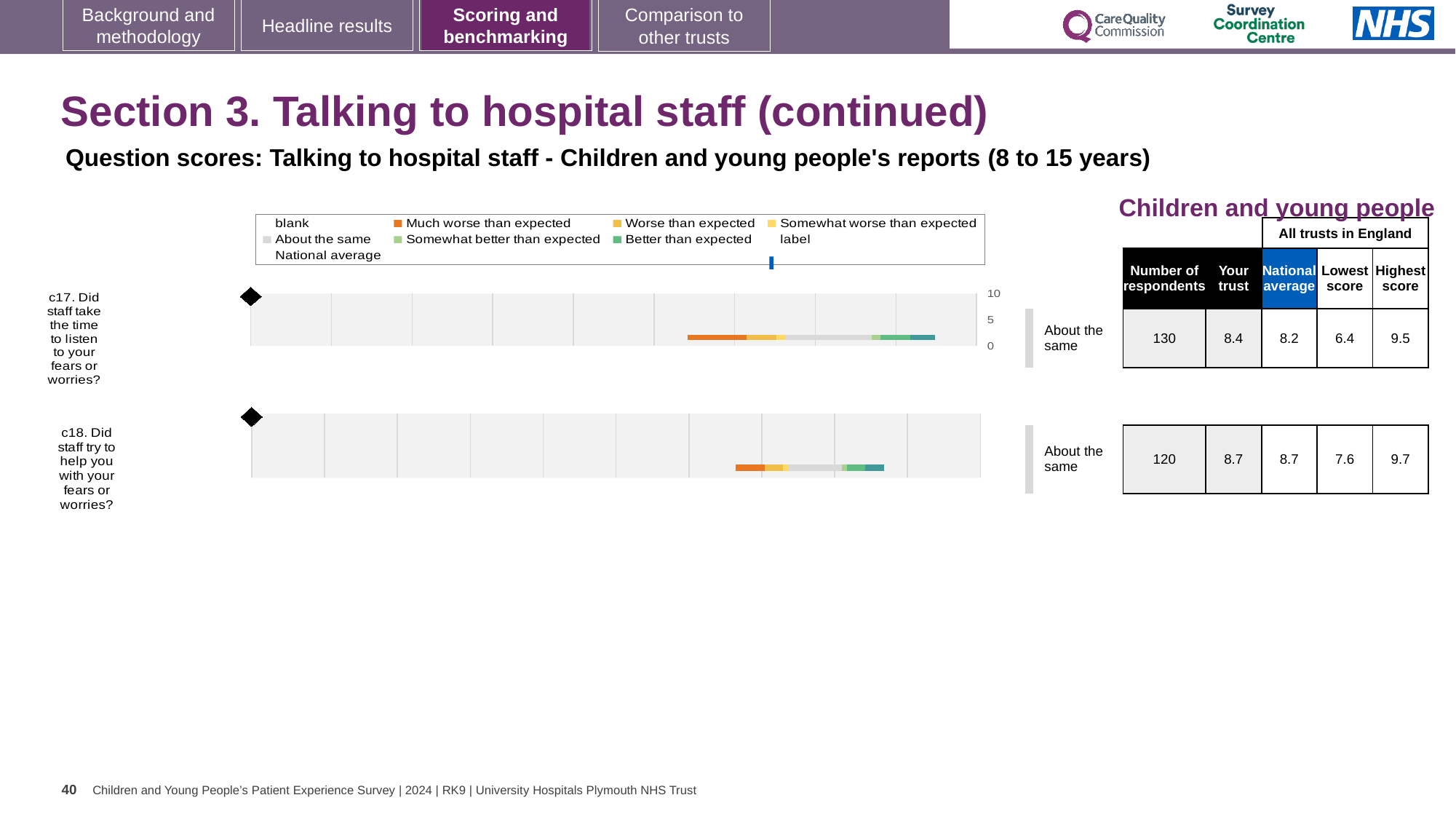
What is the difference between the 'Your trust' scores for c18 and c17? 0.3 What is the national average score for c18 (Did staff try to help you with your fears or worries?)? 8.7 Which question has the higher 'Your trust' score, c17 or c18? c18 What is the lowest score across all trusts in England for c18? 7.6 What is the highest score across all trusts in England for c17? 9.5 What is the 'Your trust' score for c17 (Did staff take the time to listen to your fears or worries?)? 8.4 How many survey questions are plotted on the slide? 2 Is the 'Your trust' score for c17 greater or less than 5 on the chart axis? greater How many respondents answered c17? 130 What benchmark category is shown next to the c17 bar? About the same What is the difference between the highest and lowest scores for c18? 2.1 What kind of chart is used to show the scores for c17 and c18? bar chart